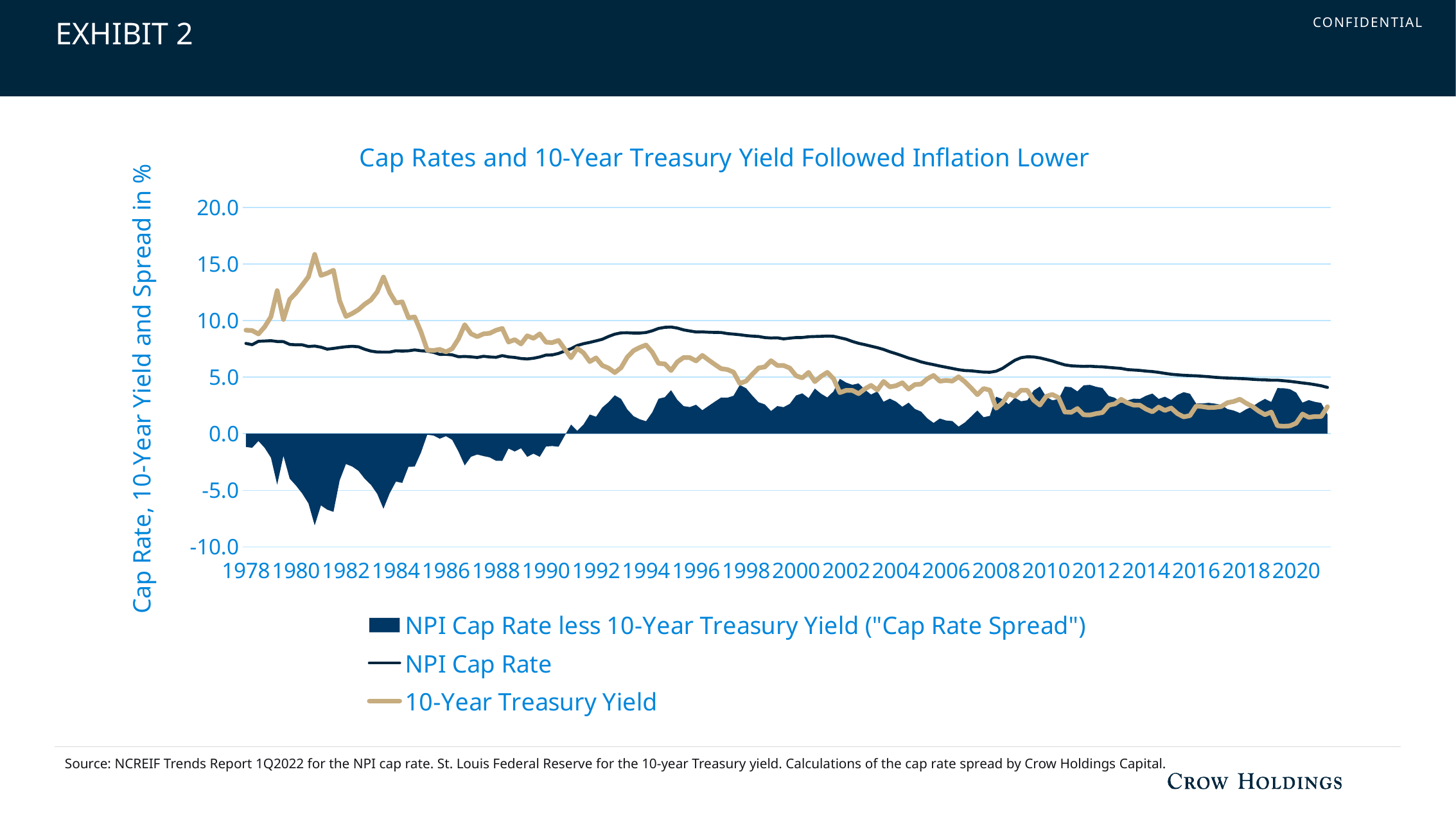
In 1981, which is higher: the 10-Year Treasury Yield or the NPI Cap Rate? 10-Year Treasury Yield In 2020, which is higher: the NPI Cap Rate or the 10-Year Treasury Yield? NPI Cap Rate Is the 10-Year Treasury Yield in 1981 greater or less than 10.0? greater Does the NPI Cap Rate rise or fall between 2002 and 2020? fall What kind of chart is shown on the slide? Line and area chart Is the 10-Year Treasury Yield in 2020 greater or less than 5.0? less How many series does the chart's legend list? 3 Is the Cap Rate Spread in 1981 greater or less than -5.0? less What is the label on the vertical axis of the chart? Cap Rate, 10-Year Yield and Spread in % What is the title of the chart? Cap Rates and 10-Year Treasury Yield Followed Inflation Lower